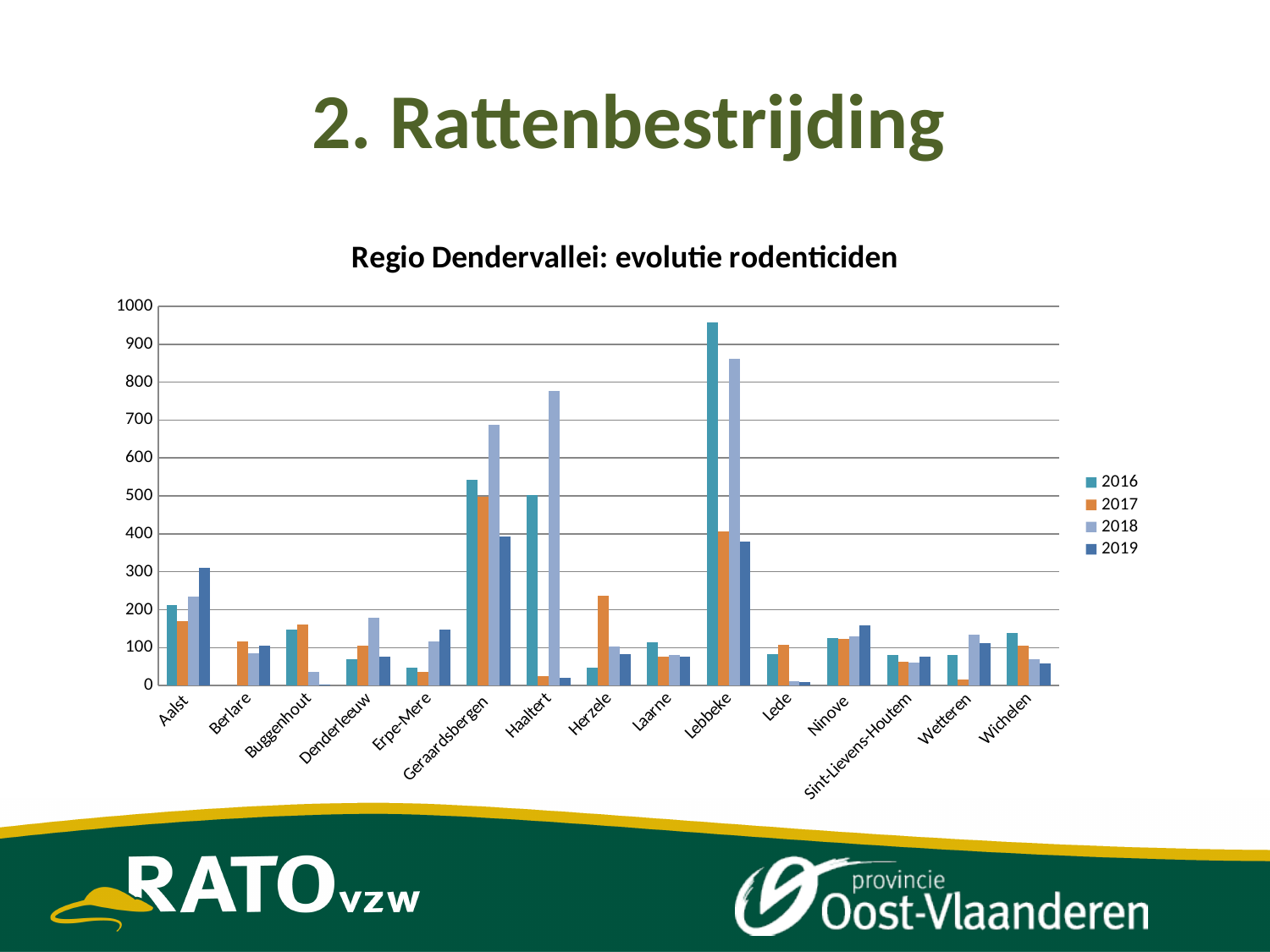
For Herzele, which is larger: the 2016 value or the 2017 value? 2017 What kind of chart is shown on the slide? bar chart Is the 2016 value for Lebbeke greater or less than 900? greater How many municipalities (categories) are shown on the x axis? 15 Which municipality has the highest value for 2016? Lebbeke Is the 2018 value for Lede greater or less than 100? less Which municipality has the highest value for 2017? Geraardsbergen How many series does the legend list? 4 Is the 2018 value for Haaltert greater or less than 700? greater For Haaltert, which is larger: the 2016 value or the 2017 value? 2016 Which municipality has the highest value for 2018? Lebbeke What is the title of the chart? Regio Dendervallei: evolutie rodenticiden